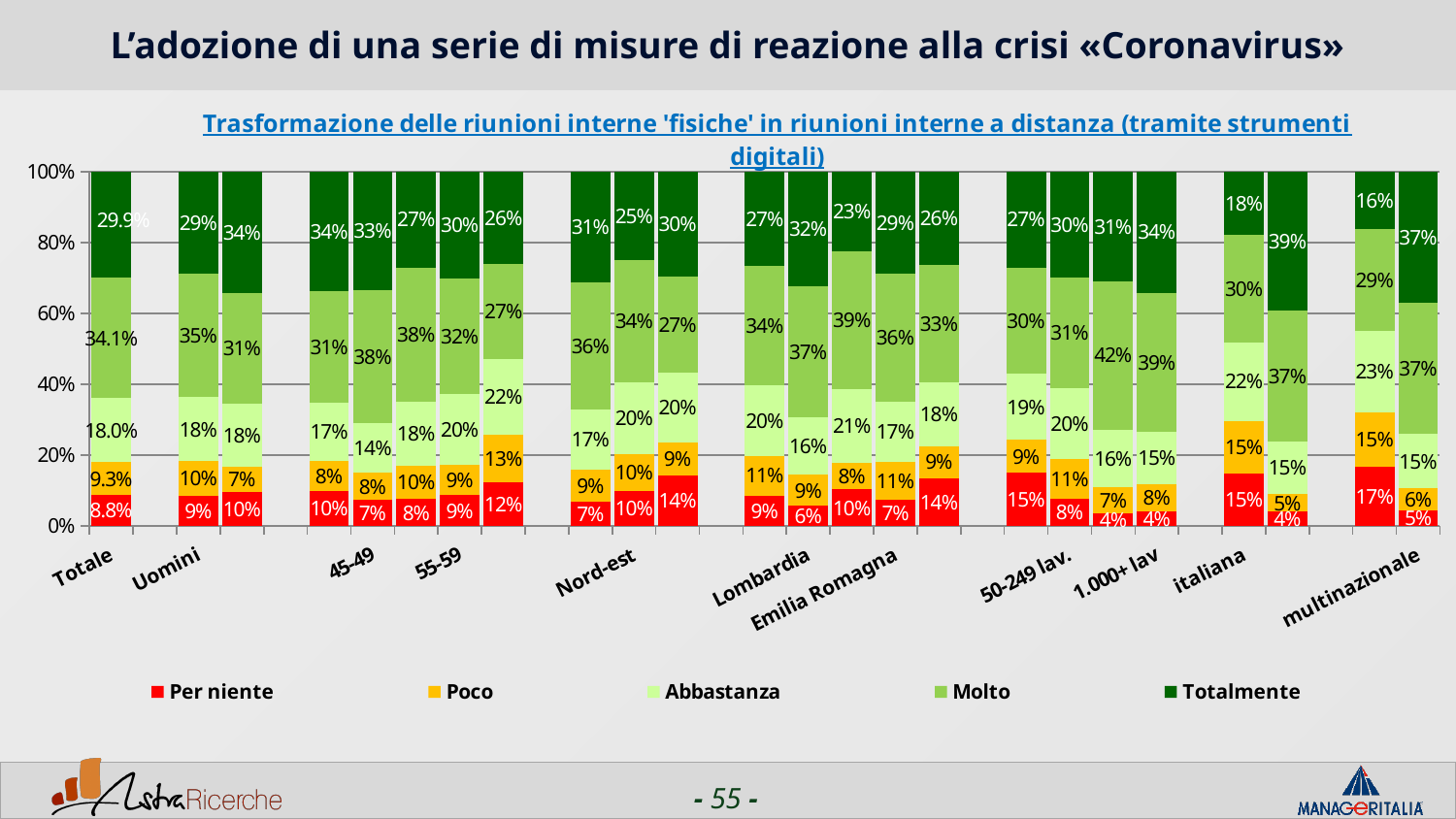
In the Totale bar, which is larger: the 'Molto' segment or the 'Totalmente' segment? Molto What kind of chart is shown on the slide? Stacked bar chart What is the 'Molto' value for the Totale bar? 34.1% How many series does the legend list? 5 Which has the larger 'Totalmente' value: italiana or multinazionale? multinazionale Which legend entry is shown in red? Per niente What is the 'Abbastanza' value for the Totale bar? 18.0% What is the 'Totalmente' value for the Totale bar? 29.9% What is the 'Totalmente' value for multinazionale? 37% In the Totale bar, what is the difference between the 'Molto' value and the 'Abbastanza' value? 16.1 percentage points What is the 'Per niente' value for the Totale bar? 8.8% What is the 'Molto' value for Uomini? 35%